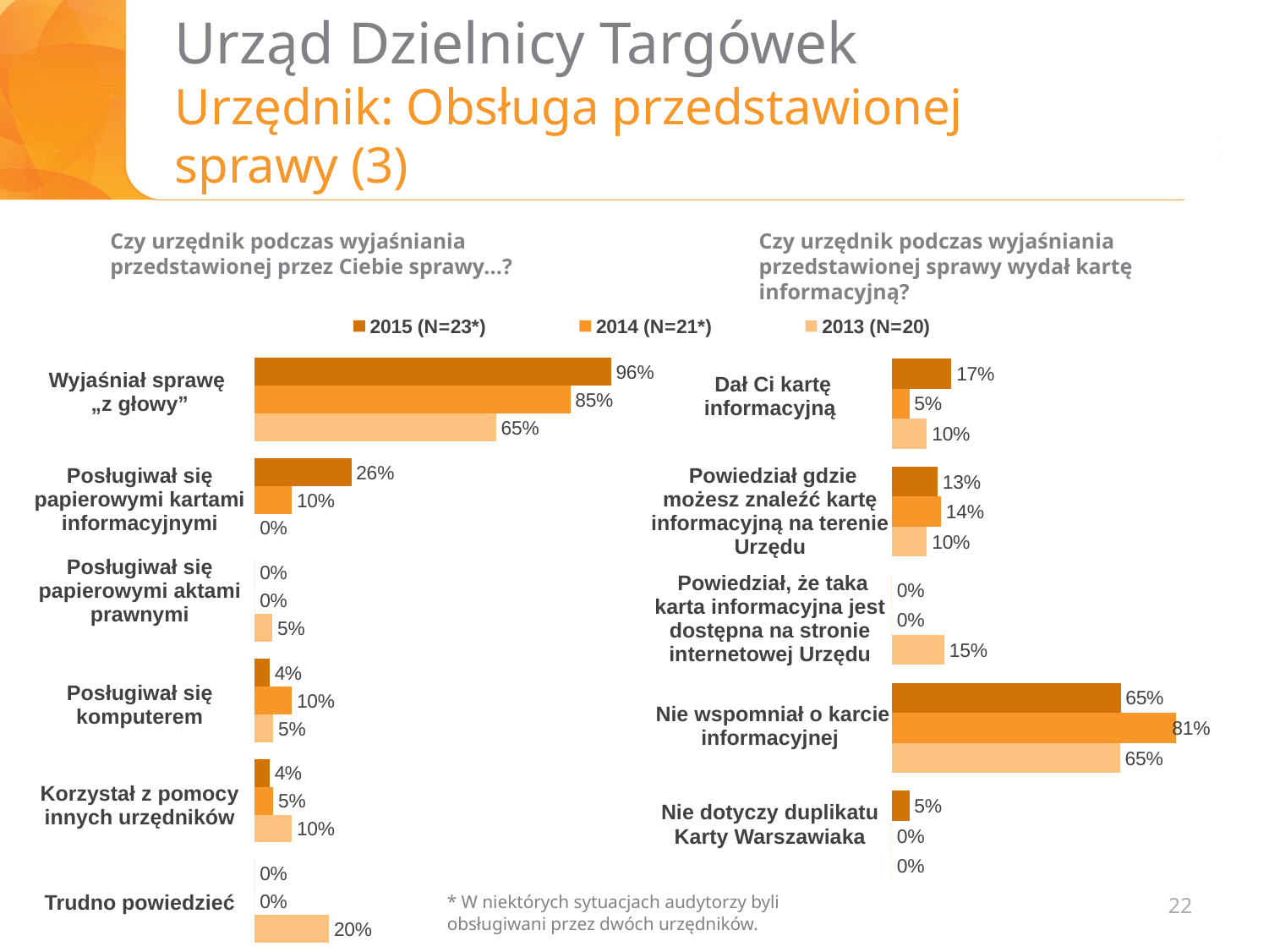
In the left chart, which category has the highest 2015 value? Wyjaśniał sprawę „z głowy” In the left chart, what is the 2014 value for "Posługiwał się komputerem"? 10% In the right chart, what is the difference between the 2014 and 2015 values for "Nie wspomniał o karcie informacyjnej"? 16 percentage points What type of chart is used on this slide? Bar chart In the left chart ("Czy urzędnik podczas wyjaśniania przedstawionej przez Ciebie sprawy...?"), what is the 2015 value for "Wyjaśniał sprawę „z głowy”"? 96% In the left chart, what is the difference between the 2015 and 2013 values for "Wyjaśniał sprawę „z głowy”"? 31 percentage points In the right chart, what is the 2015 value for "Dał Ci kartę informacyjną"? 17% In the left chart, how many categories are shown? 6 In the right chart, which is larger for "Dał Ci kartę informacyjną": the 2015 value or the 2014 value? 2015 In the right chart ("Czy urzędnik podczas wyjaśniania przedstawionej sprawy wydał kartę informacyjną?"), what is the 2014 value for "Nie wspomniał o karcie informacyjnej"? 81% How many series does the legend list? 3 In the left chart, what is the 2013 value for "Trudno powiedzieć"? 20%